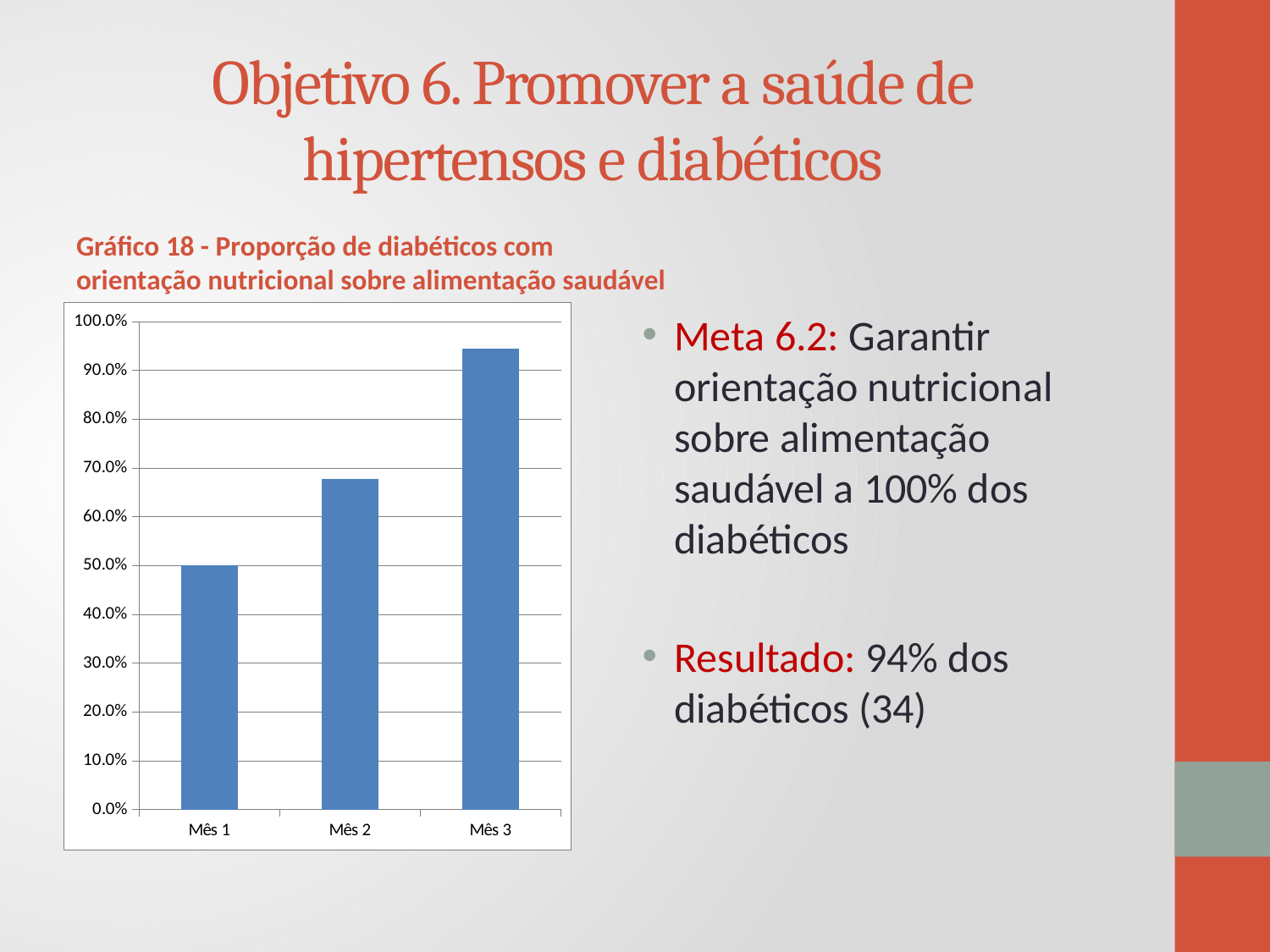
What is the title of the chart on the slide? Gráfico 18 - Proporção de diabéticos com orientação nutricional sobre alimentação saudável Do the values rise or fall from Mês 1 to Mês 3? rise What is the value for Mês 1 in the chart? 50.0% What is the highest value shown on the chart's y axis? 100.0% Which month has the highest value in the chart? Mês 3 Is the value for Mês 2 greater or less than 60.0%? greater Which month has the lowest value in the chart? Mês 1 Is the value for Mês 2 greater or less than 70.0%? less Which is larger, the value for Mês 2 or the value for Mês 3? Mês 3 How many categories are plotted on the x axis of the chart? 3 Is the value for Mês 3 greater or less than 90.0%? greater What kind of chart is shown on the slide? bar chart